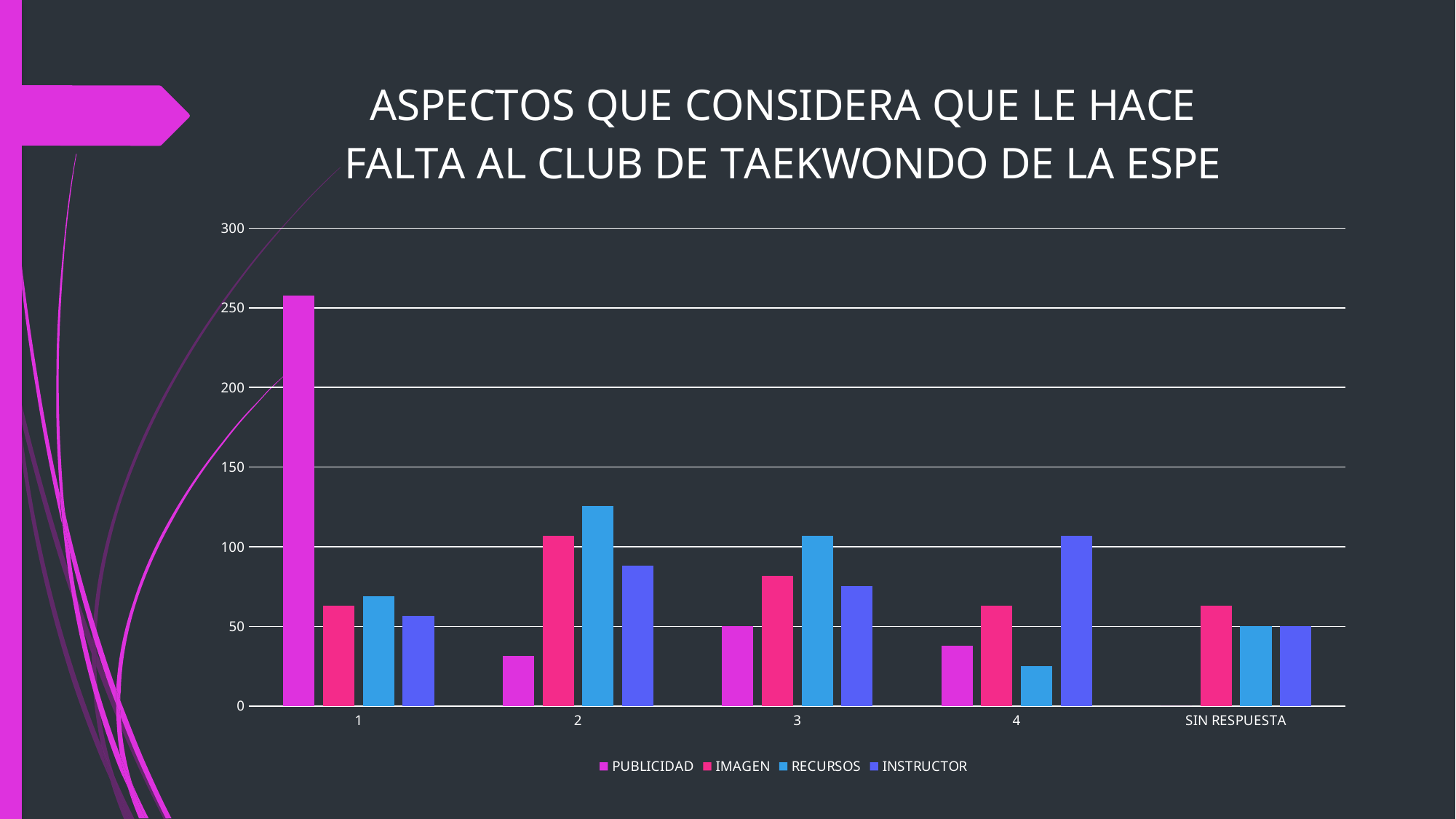
How many series does the legend list? 4 What are the four series listed in the legend? PUBLICIDAD, IMAGEN, RECURSOS, INSTRUCTOR Is the RECURSOS value for category 4 greater or less than 50? less How many categories are shown along the x axis? 5 Is the PUBLICIDAD value for category 2 greater or less than 50? less Is the RECURSOS value for category 2 greater or less than 100? greater In category 2, which is larger: IMAGEN or PUBLICIDAD? IMAGEN Which category has the highest PUBLICIDAD bar? 1 In category 4, which is larger: INSTRUCTOR or RECURSOS? INSTRUCTOR Which series has the lowest bar in category 4? RECURSOS What kind of chart is shown on the slide? bar chart